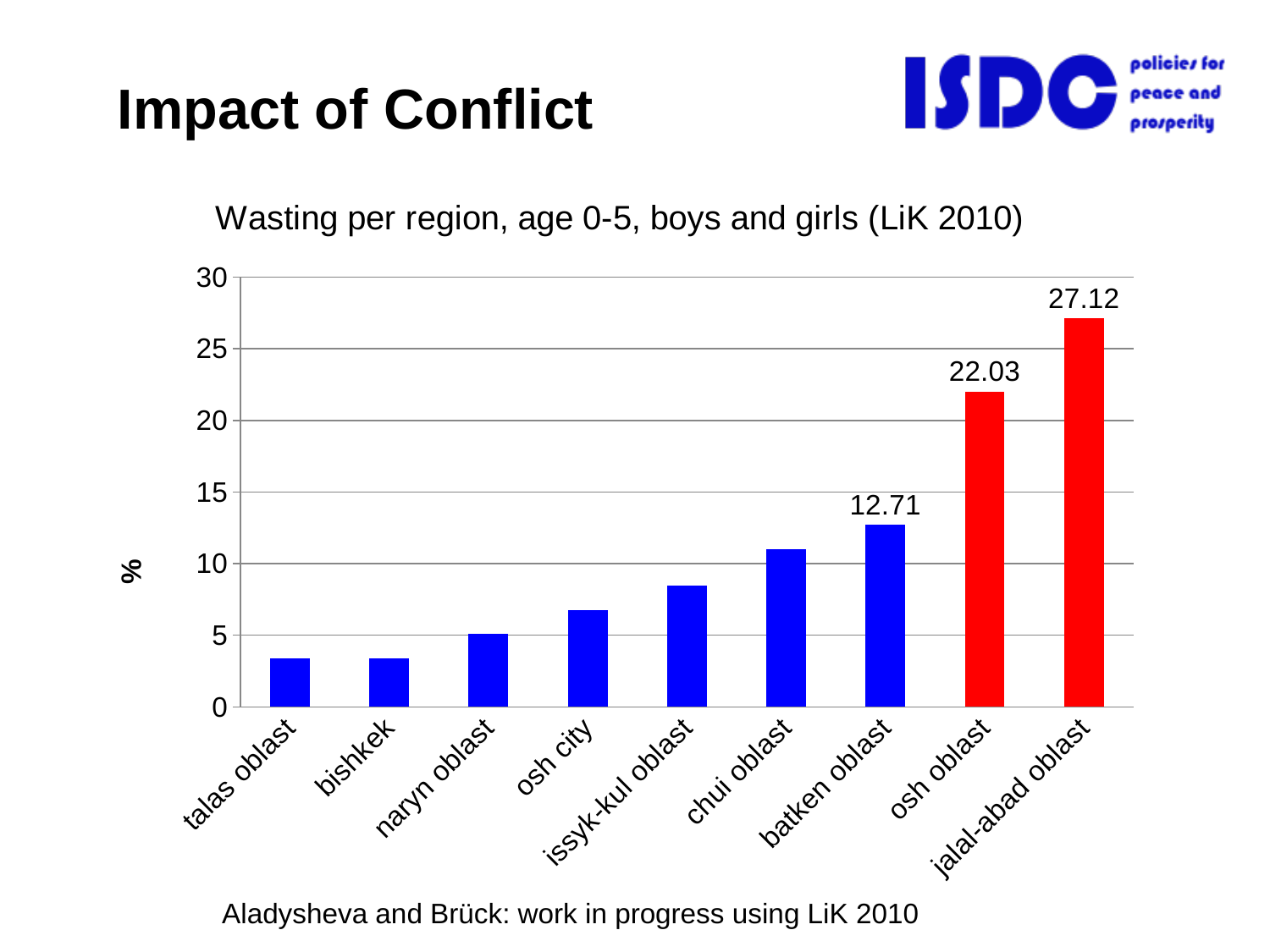
What is the wasting value for jalal-abad oblast? 27.12 What is the difference between the wasting values for osh oblast and batken oblast? 9.32 Which region has the highest wasting value? jalal-abad oblast Is the wasting value for chui oblast greater or less than 10? greater Do the wasting values rise or fall from left to right along the x axis? rise How many regions are shown in the chart? 9 Which has a higher wasting value, chui oblast or osh city? chui oblast What is the difference between the wasting values for jalal-abad oblast and osh oblast? 5.09 What kind of chart is shown on the slide? bar chart What is the wasting value for osh oblast? 22.03 Is the wasting value for issyk-kul oblast greater or less than 10? less What is the wasting value for batken oblast? 12.71